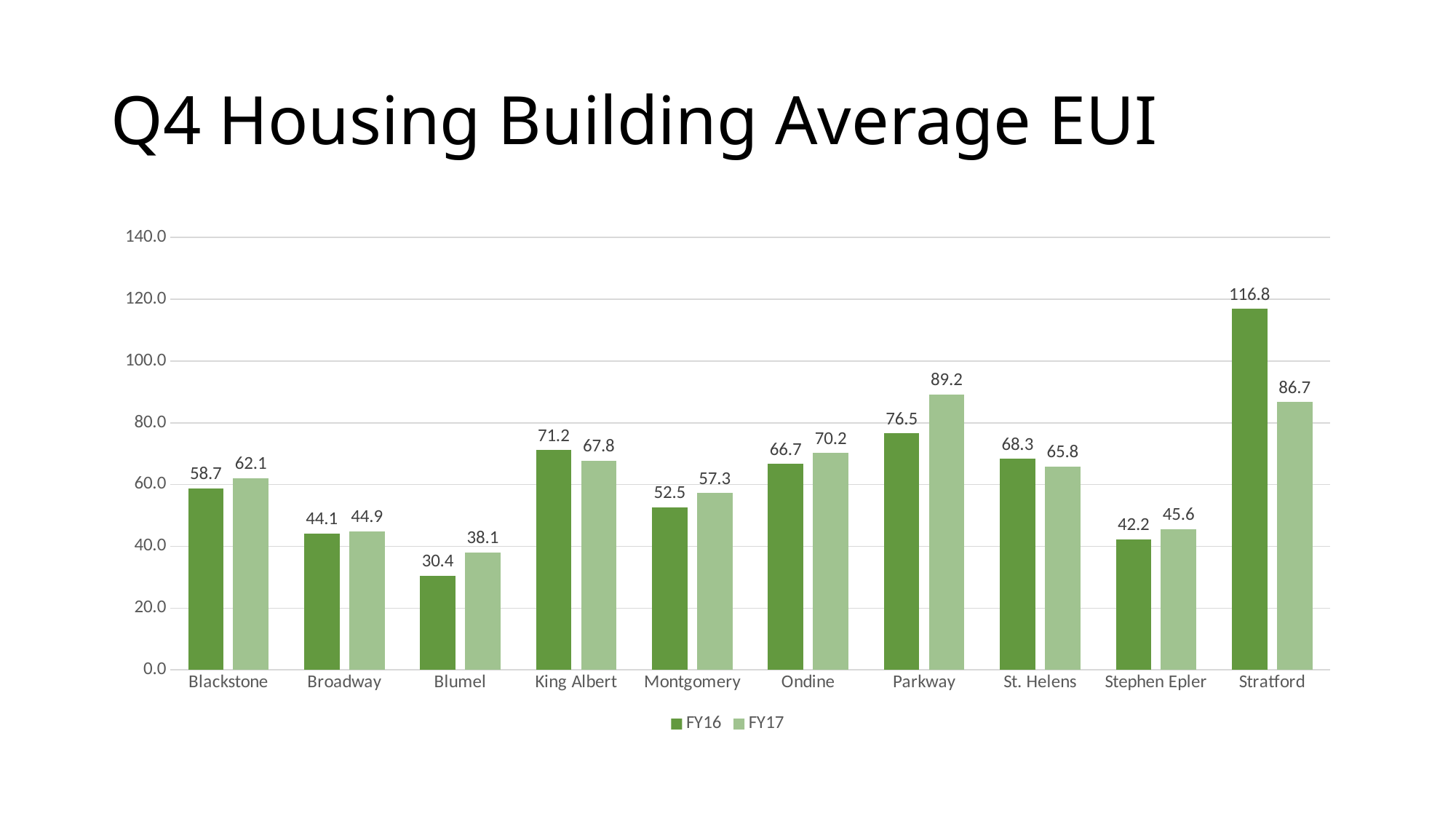
Is the FY17 value for Ondine greater or less than 60.0? greater What is the FY16 value for Stratford? 116.8 What is the FY16 value for Blumel? 30.4 Which is larger for St. Helens, the FY16 value or the FY17 value? FY16 Which building has the highest FY17 value? Parkway What kind of chart is shown on the slide? Bar chart How many buildings are shown on the x axis? 10 Which building has the lowest FY16 value? Blumel What is the difference between the FY16 and FY17 values for Stratford? 30.1 How many series does the legend list? 2 What is the FY17 value for Parkway? 89.2 What is the title of the chart? Q4 Housing Building Average EUI